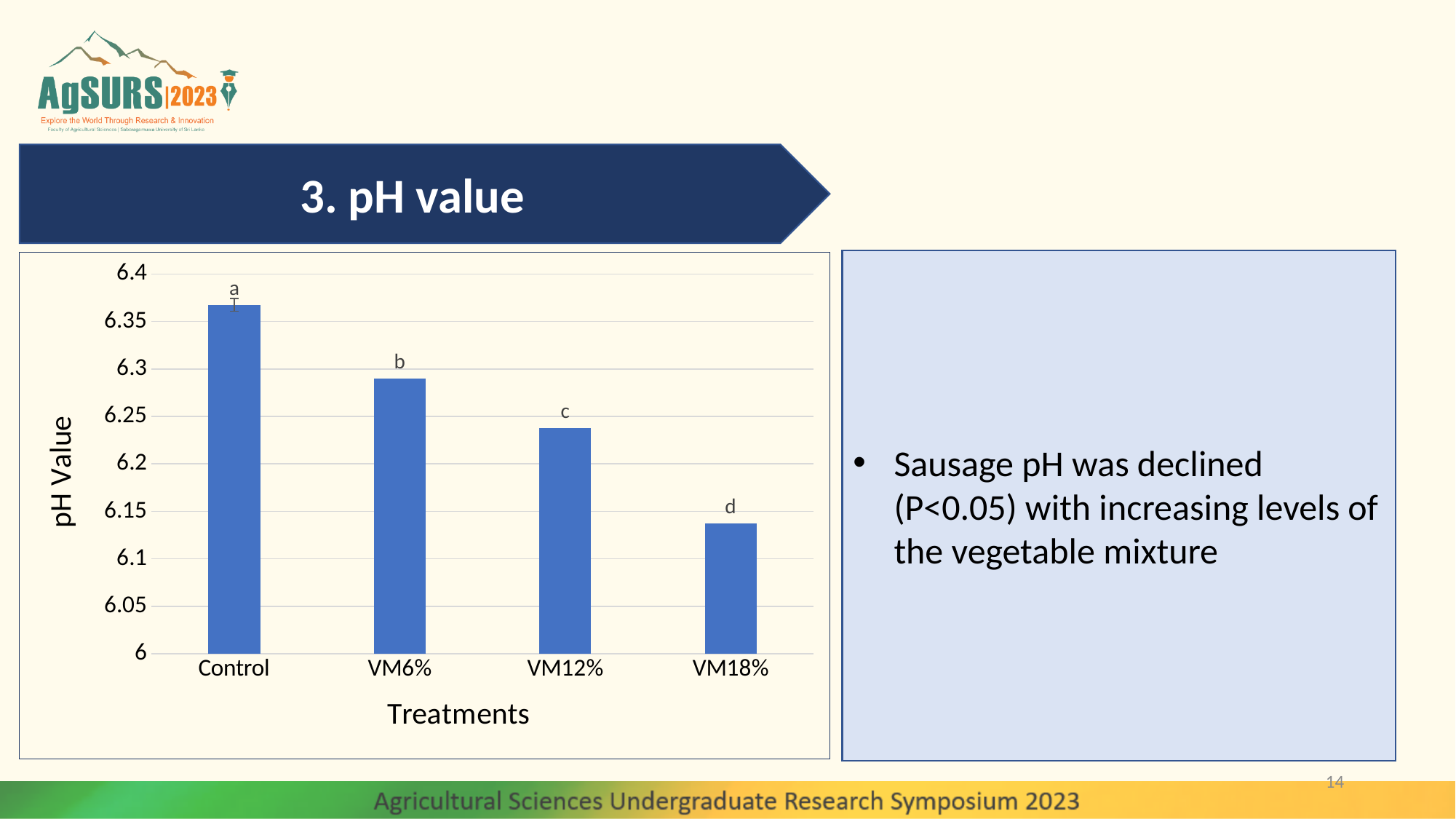
What is the title of the y axis of the chart? pH Value Which has a higher pH value, VM6% or VM12%? VM6% Is the pH value for VM18% greater or less than 6.1? greater Is the pH value for VM6% greater or less than 6.25? greater What kind of chart is shown on the slide? bar chart Is the pH value for VM12% greater or less than 6.2? greater Do the pH values rise or fall from Control to VM18% along the x axis? fall How many treatments are plotted on the x axis of the chart? 4 Which has a higher pH value, Control or VM18%? Control Which treatment has the lowest pH value? VM18% Which treatment has the highest pH value? Control